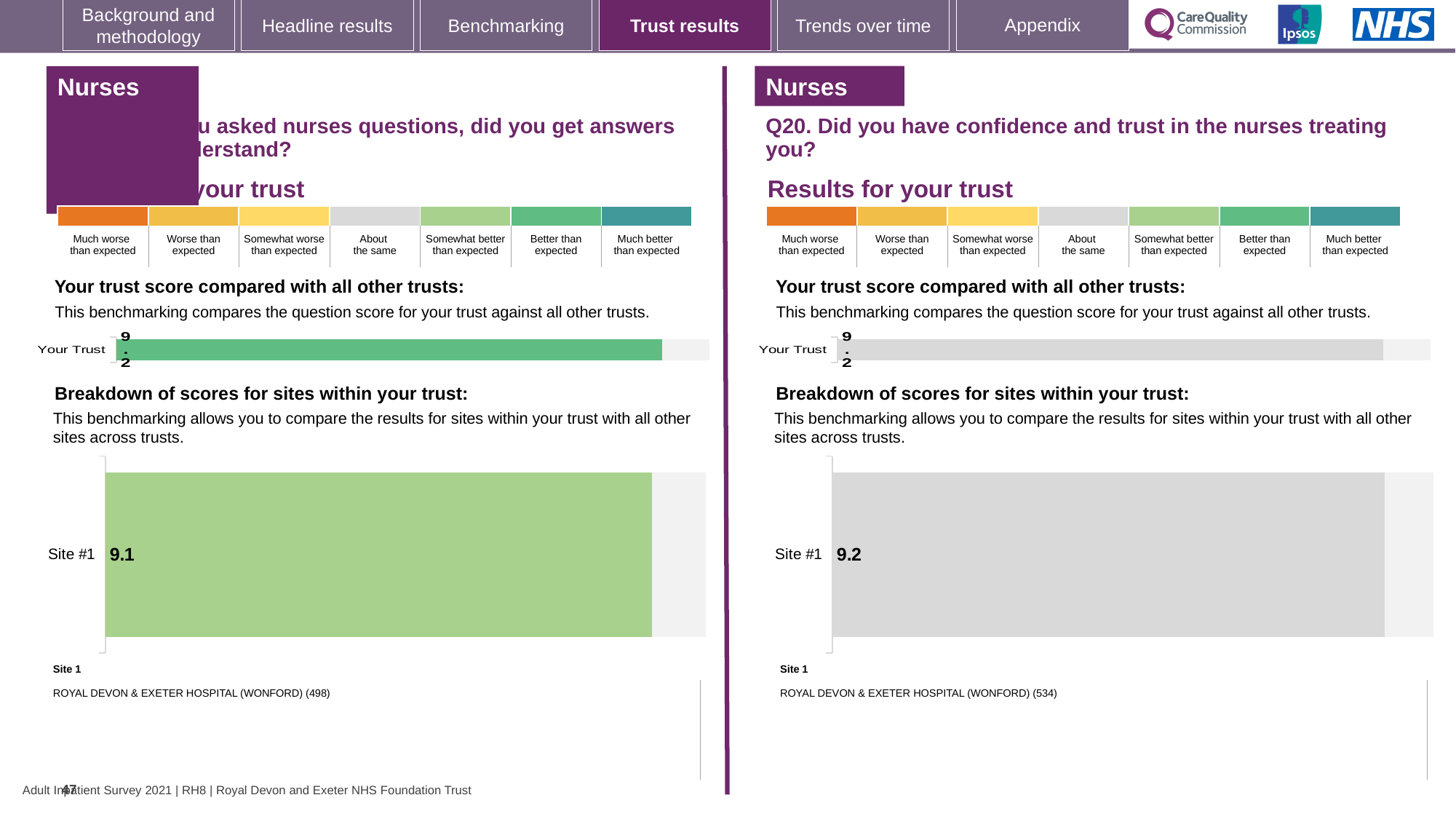
What colour is the Site #1 bar on the right-hand (Q20) site breakdown chart? Grey On the left-hand 'Breakdown of scores for sites within your trust' chart, what is the score for Site #1? 9.1 How many bars are plotted on the left-hand 'Your trust score compared with all other trusts' chart? 1 What is the category label of the single bar on the left-hand 'Breakdown of scores for sites within your trust' chart? Site #1 What is the difference between the Site #1 score on the right-hand (Q20) site breakdown chart and the Site #1 score on the left-hand site breakdown chart? 0.1 What colour is the Site #1 bar on the left-hand site breakdown chart? Light green Which Site #1 score is larger: the one on the left-hand site breakdown chart or the one on the right-hand (Q20) site breakdown chart? The right-hand (Q20) chart, 9.2 On the right-hand (Q20) 'Your trust score compared with all other trusts' chart, what is the score shown for Your Trust? 9.2 On the right-hand 'Breakdown of scores for sites within your trust' chart (Q20), what is the score for Site #1? 9.2 What kind of chart is the 'Breakdown of scores for sites within your trust' chart on the right-hand side of the slide? Bar chart How many sites are shown on the right-hand (Q20) 'Breakdown of scores for sites within your trust' chart? 1